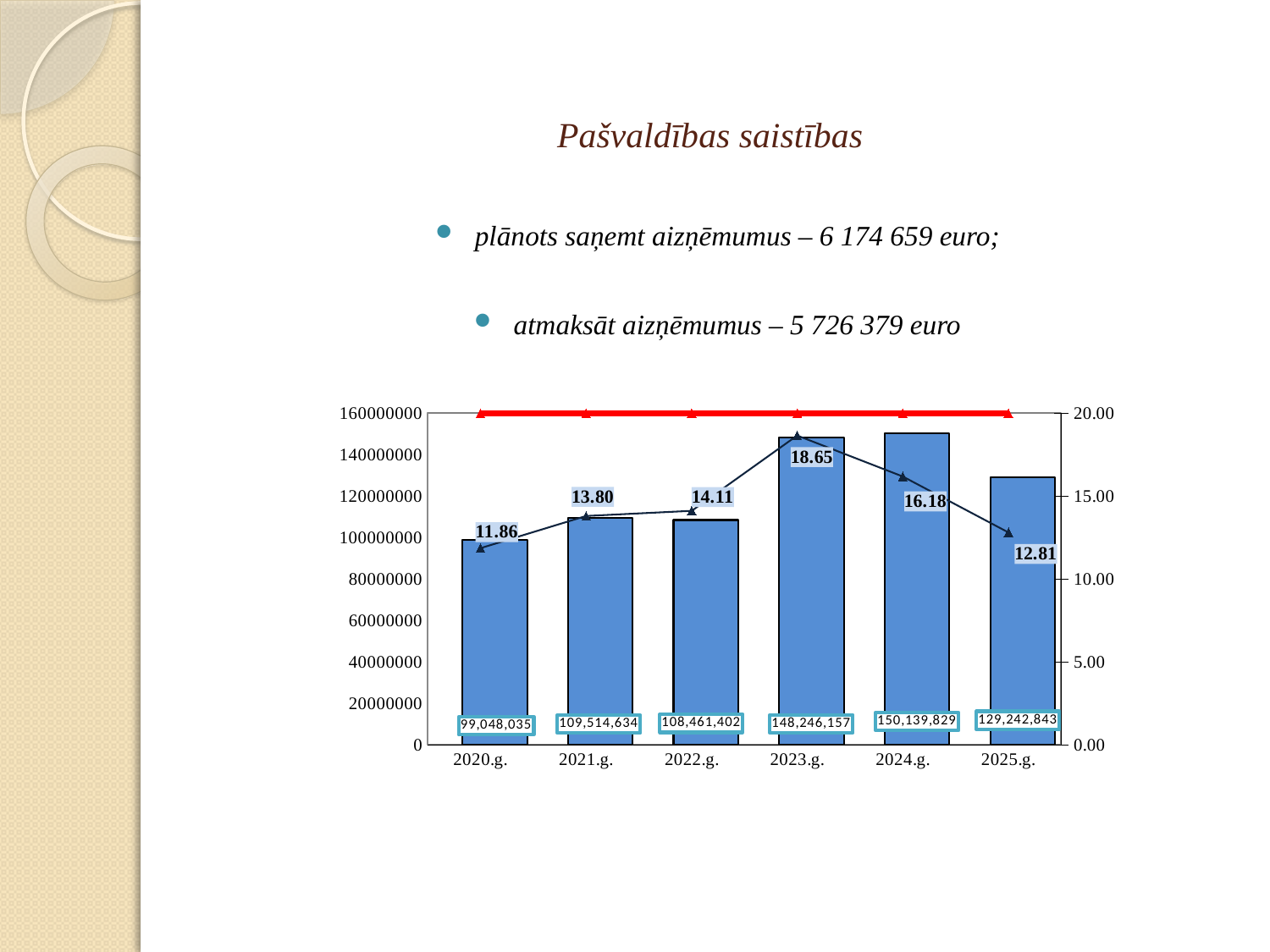
Which year has the highest bar value? 2024.g. Which bar is larger, 2021.g. or 2022.g.? 2021.g. What is the line value (right axis) labelled for 2021.g.? 13.80 In which year does the line series reach its highest labelled value? 2023.g. Which year has the lowest bar value? 2020.g. What is the bar value for 2020.g.? 99,048,035 What is the difference between the bar values for 2024.g. and 2023.g.? 1,893,672 What is the bar value for 2023.g.? 148,246,157 What is the difference between the line values for 2023.g. and 2025.g.? 5.84 Does the line series rise or fall from 2023.g. to 2025.g.? fall What is the line value (right axis) labelled for 2025.g.? 12.81 How many years are shown on the x axis? 6